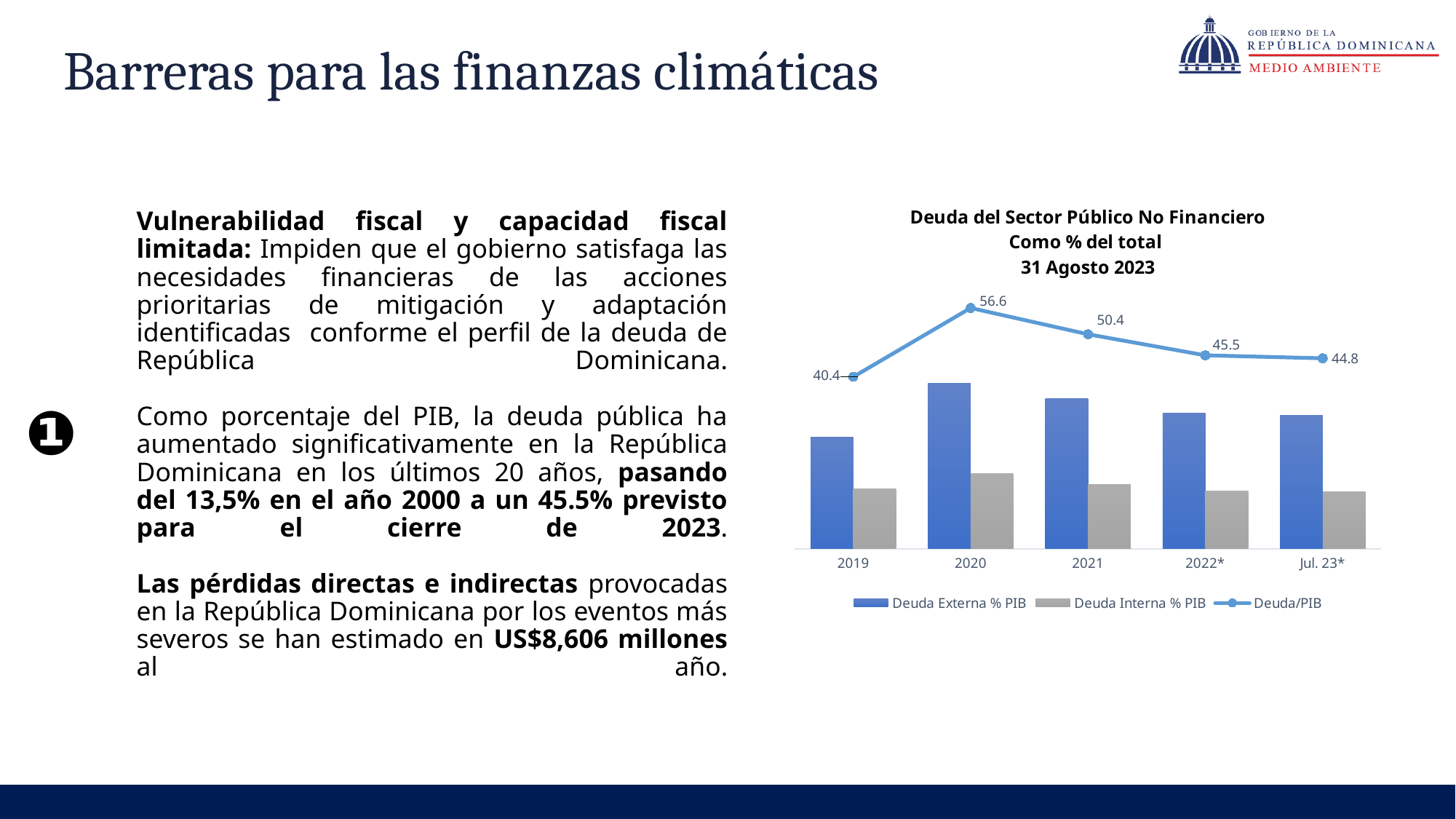
What kind of chart is shown on the slide? Combination bar and line chart What is the difference between the Deuda/PIB values for 2020 and 2019? 16.2 What is the Deuda/PIB value for 2020? 56.6 How many series does the chart legend list? 3 In 2020, which bar is taller, Deuda Externa % PIB or Deuda Interna % PIB? Deuda Externa % PIB Which is larger, the Deuda/PIB value for 2021 or for 2022*? 2021 What is the Deuda/PIB value for Jul. 23*? 44.8 In which year does the Deuda/PIB line reach its highest value? 2020 What is the Deuda/PIB value for 2019? 40.4 In which year is the Deuda/PIB value lowest? 2019 Does the Deuda/PIB line rise or fall from 2020 to Jul. 23*? Fall How many periods are shown on the x axis of the chart? 5